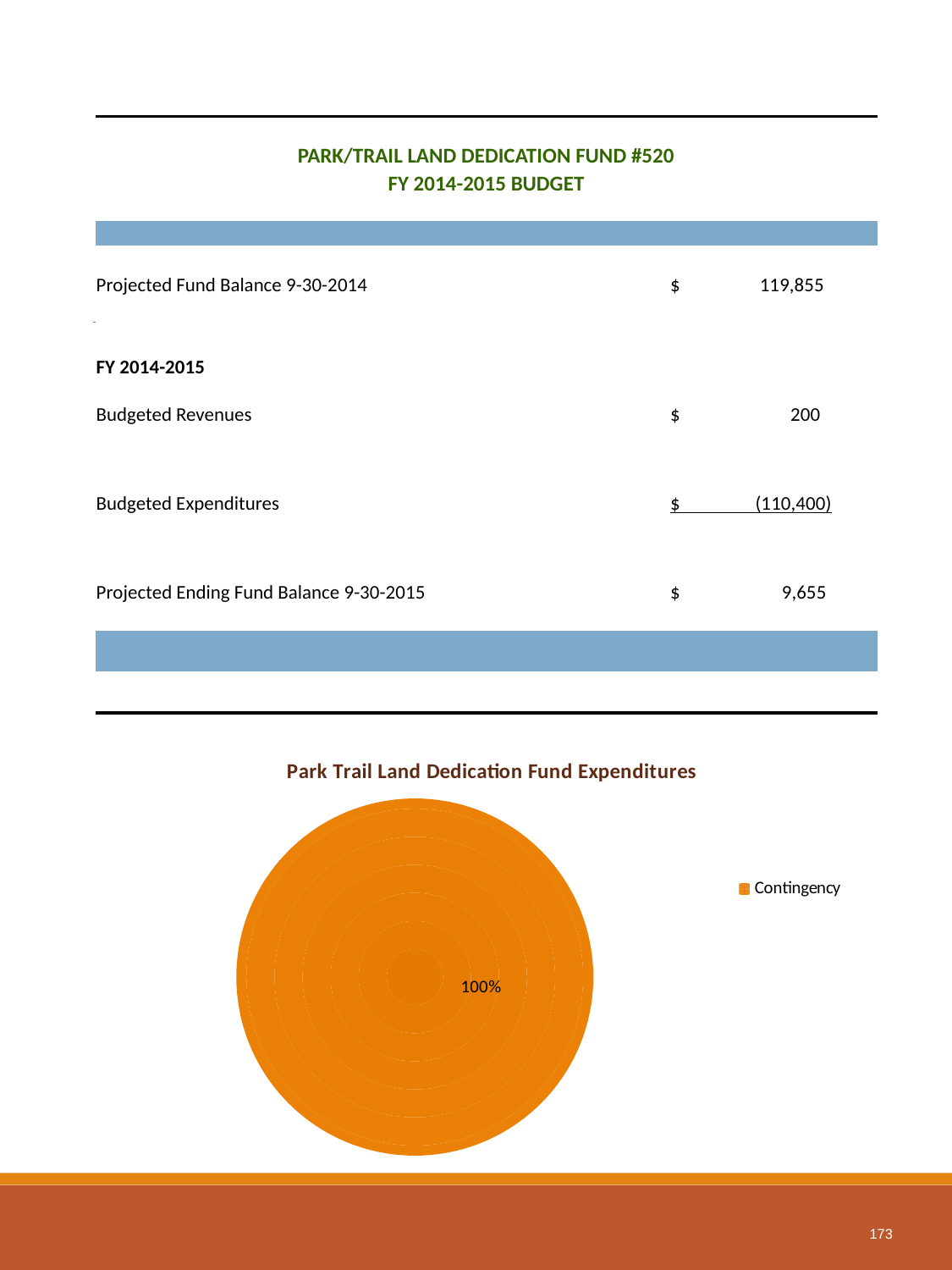
How many slices does the pie chart have? 1 What share of the pie does the Contingency slice represent? 100% What is the title of the pie chart? Park Trail Land Dedication Fund Expenditures What percentage label is printed on the pie chart? 100% How many entries does the legend of the pie chart list? 1 What kind of chart is shown under the title "Park Trail Land Dedication Fund Expenditures"? pie chart What is the name of the only category shown in the pie chart's legend? Contingency